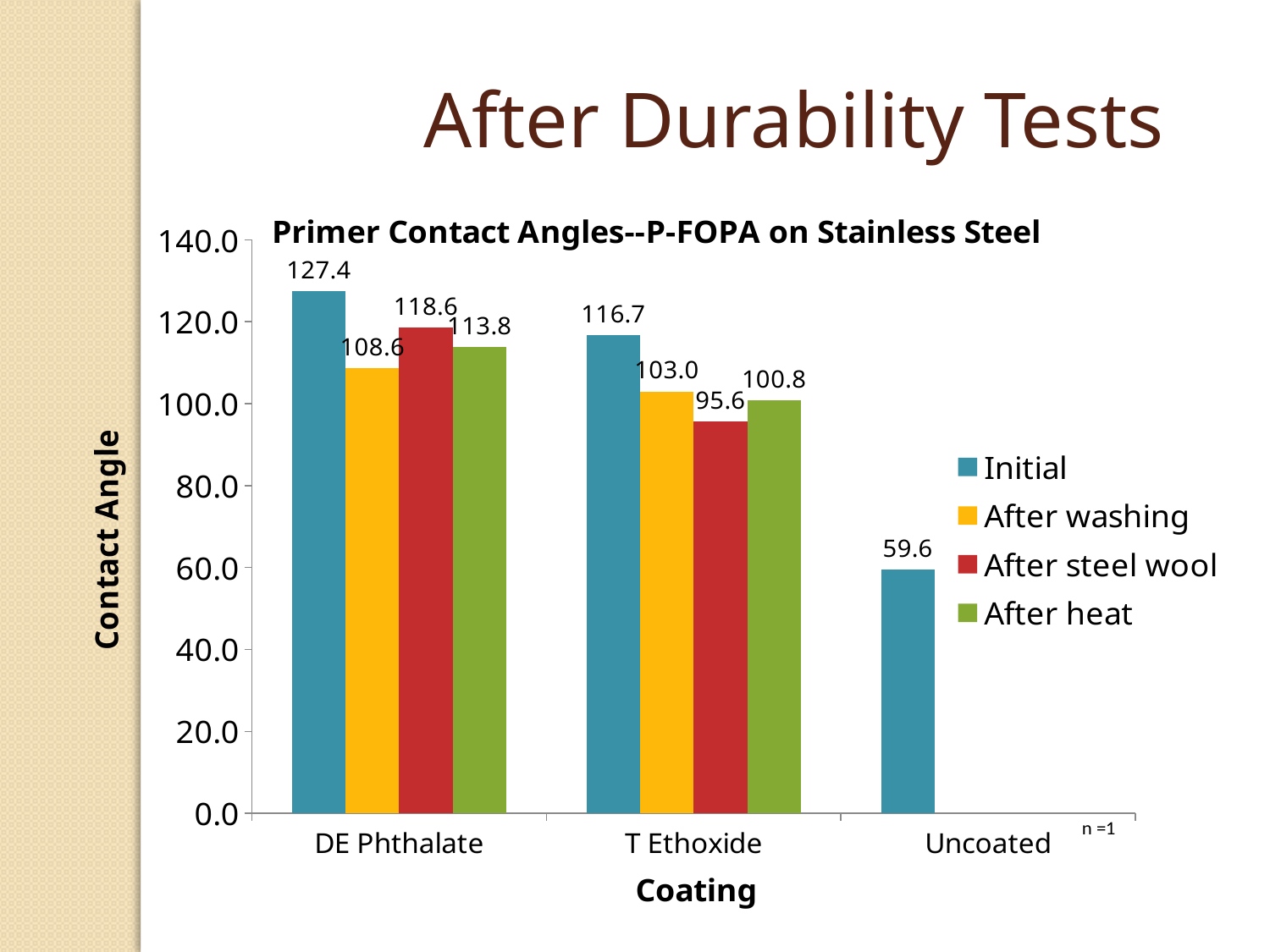
How many coating categories are shown on the x axis? 3 How many series does the legend list? 4 What is the title of the chart? Primer Contact Angles--P-FOPA on Stainless Steel What is the After steel wool contact angle for T Ethoxide? 95.6 What is the After heat contact angle for DE Phthalate? 113.8 Which coating has the lowest Initial contact angle? Uncoated Which coating has the highest Initial contact angle? DE Phthalate What is the difference between the Initial and After washing contact angles for DE Phthalate? 18.8 What is the contact angle for Uncoated? 59.6 Which is larger for T Ethoxide: the After washing value or the After heat value? After washing What is the Initial contact angle for DE Phthalate? 127.4 What kind of chart is shown on the slide? Bar chart